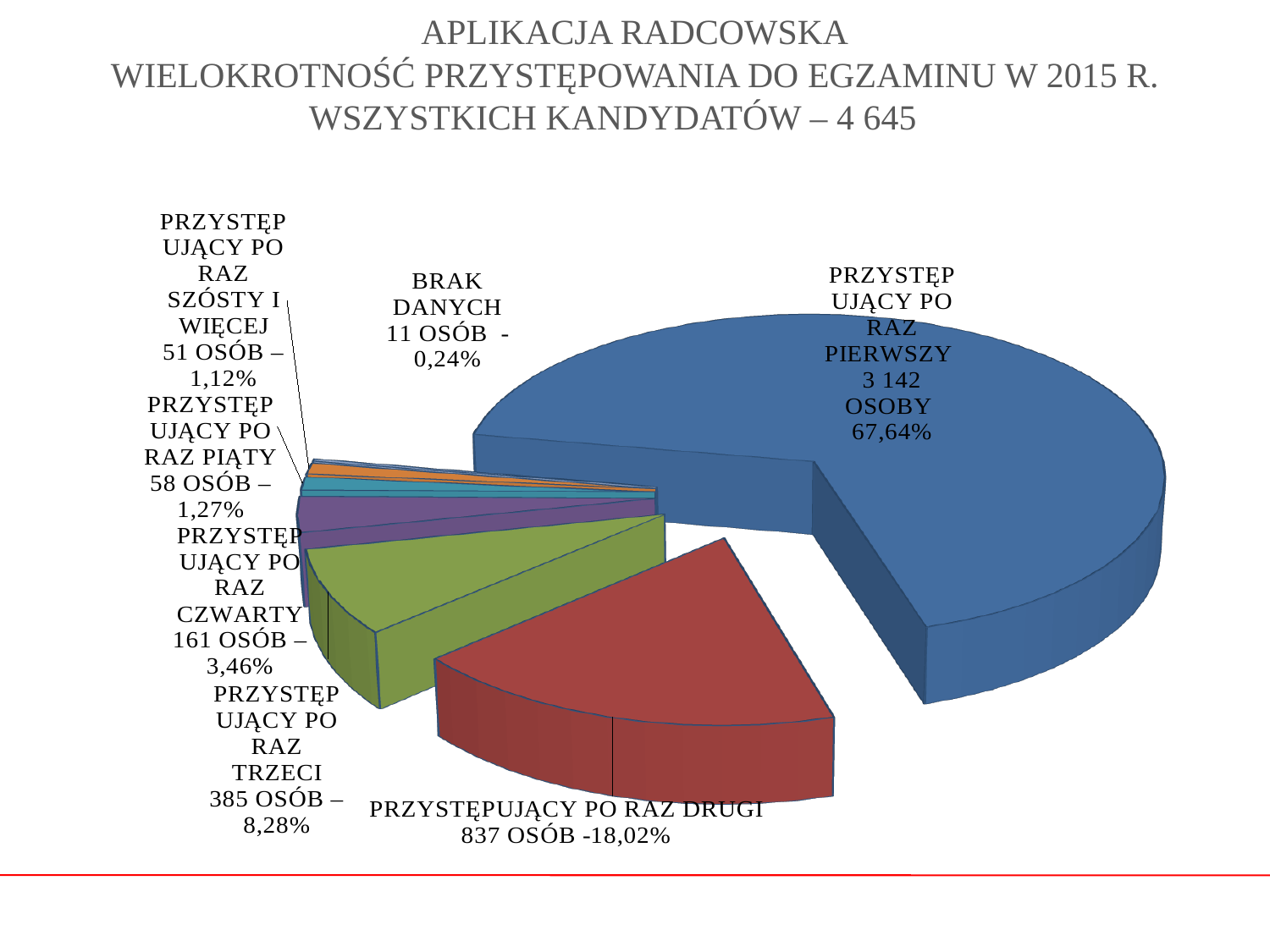
What kind of chart is shown on the slide? pie chart How many people are in the PRZYSTĘPUJĄCY PO RAZ TRZECI category? 385 How many people took the exam for the first time (PRZYSTĘPUJĄCY PO RAZ PIERWSZY)? 3 142 What percentage is shown for BRAK DANYCH? 0,24% How many slices does the pie chart have? 7 What share of the pie is PRZYSTĘPUJĄCY PO RAZ DRUGI? 18,02% What total number of candidates is given in the chart title? 4 645 Which is larger: PRZYSTĘPUJĄCY PO RAZ PIĄTY or PRZYSTĘPUJĄCY PO RAZ SZÓSTY I WIĘCEJ? PRZYSTĘPUJĄCY PO RAZ PIĄTY Which category has the smallest slice of the pie? BRAK DANYCH Which category has the largest slice of the pie? PRZYSTĘPUJĄCY PO RAZ PIERWSZY What percentage is shown for PRZYSTĘPUJĄCY PO RAZ CZWARTY? 3,46% What is the difference in number of people between PRZYSTĘPUJĄCY PO RAZ DRUGI and PRZYSTĘPUJĄCY PO RAZ TRZECI? 452